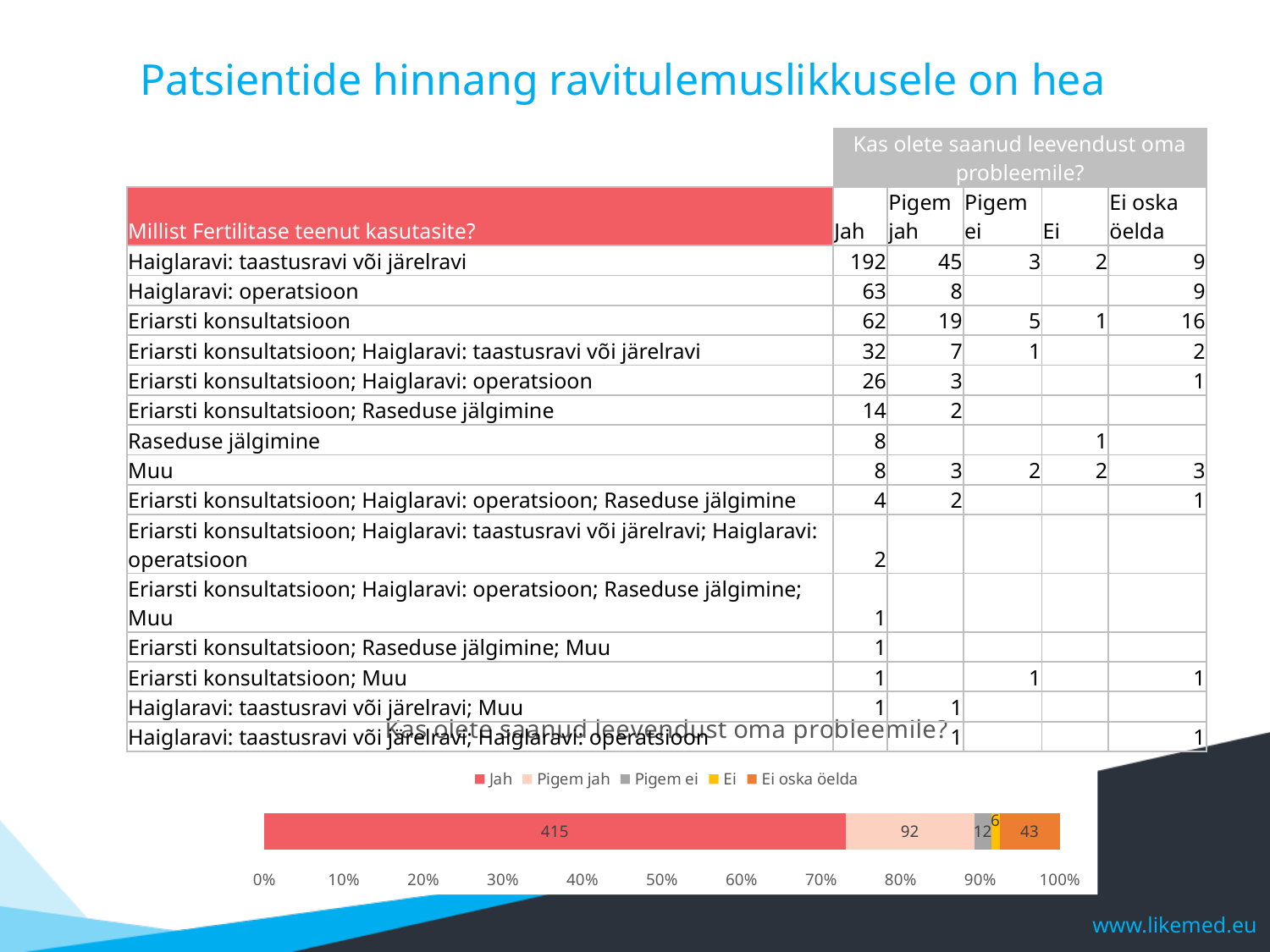
What is the value of the 'Ei oska öelda' segment in the bar chart? 43 Which segment of the bar chart has the lowest value? Ei What is the value of the 'Pigem jah' segment in the bar chart? 92 What is the value of the 'Ei' segment in the bar chart? 6 What is the total of all segments in the stacked bar? 568 What is the value of the 'Jah' segment in the bar chart? 415 What is the title of the chart at the bottom of the slide? Kas olete saanud leevendust oma probleemile? How many series does the chart legend list? 5 What is the difference between the 'Jah' and 'Pigem jah' values in the bar chart? 323 Which segment of the bar chart has the highest value? Jah Which is larger in the bar chart, 'Pigem ei' or 'Ei oska öelda'? Ei oska öelda What type of chart is shown at the bottom of the slide? Stacked bar chart